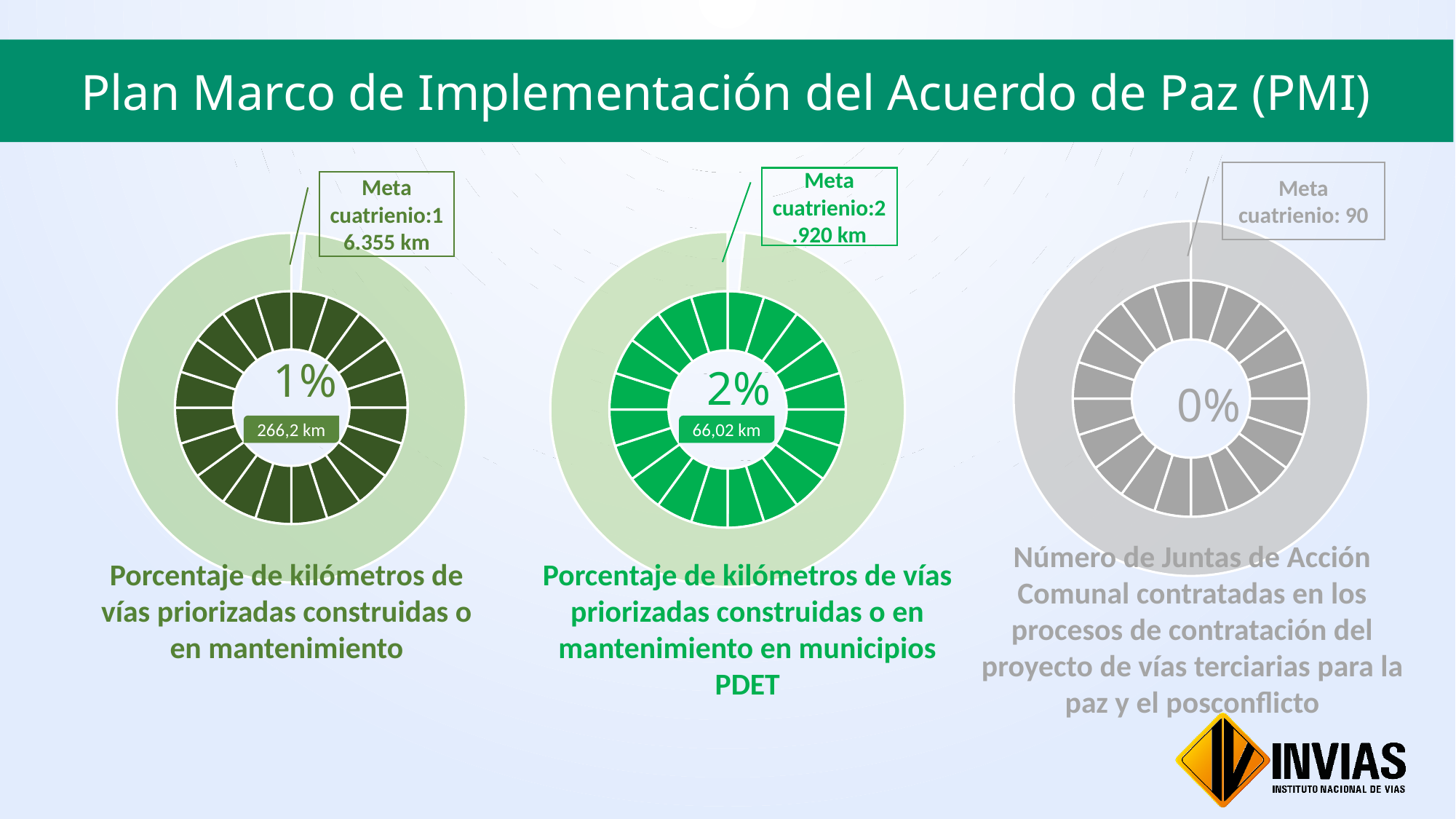
What is the 'Meta cuatrienio' value for the middle chart (municipios PDET)? 2.920 km What is the 'Meta cuatrienio' value for the right chart about Juntas de Acción Comunal? 90 What percentage is shown in the centre of the middle chart about municipios PDET? 2% How many kilometres are shown in the label inside the left chart? 266,2 km What percentage is shown in the centre of the right chart about Juntas de Acción Comunal? 0% Which of the three charts shows the highest percentage? Porcentaje de kilómetros de vías priorizadas construidas o en mantenimiento en municipios PDET Which of the three charts shows the lowest percentage? Número de Juntas de Acción Comunal contratadas What kind of chart is used for the three indicators on the slide? Donut chart How many kilometres are shown in the label inside the middle chart (municipios PDET)? 66,02 km What percentage is shown in the centre of the left chart, 'Porcentaje de kilómetros de vías priorizadas construidas o en mantenimiento'? 1% What is the 'Meta cuatrienio' value for the left chart? 16.355 km How many charts are shown on the slide? 3